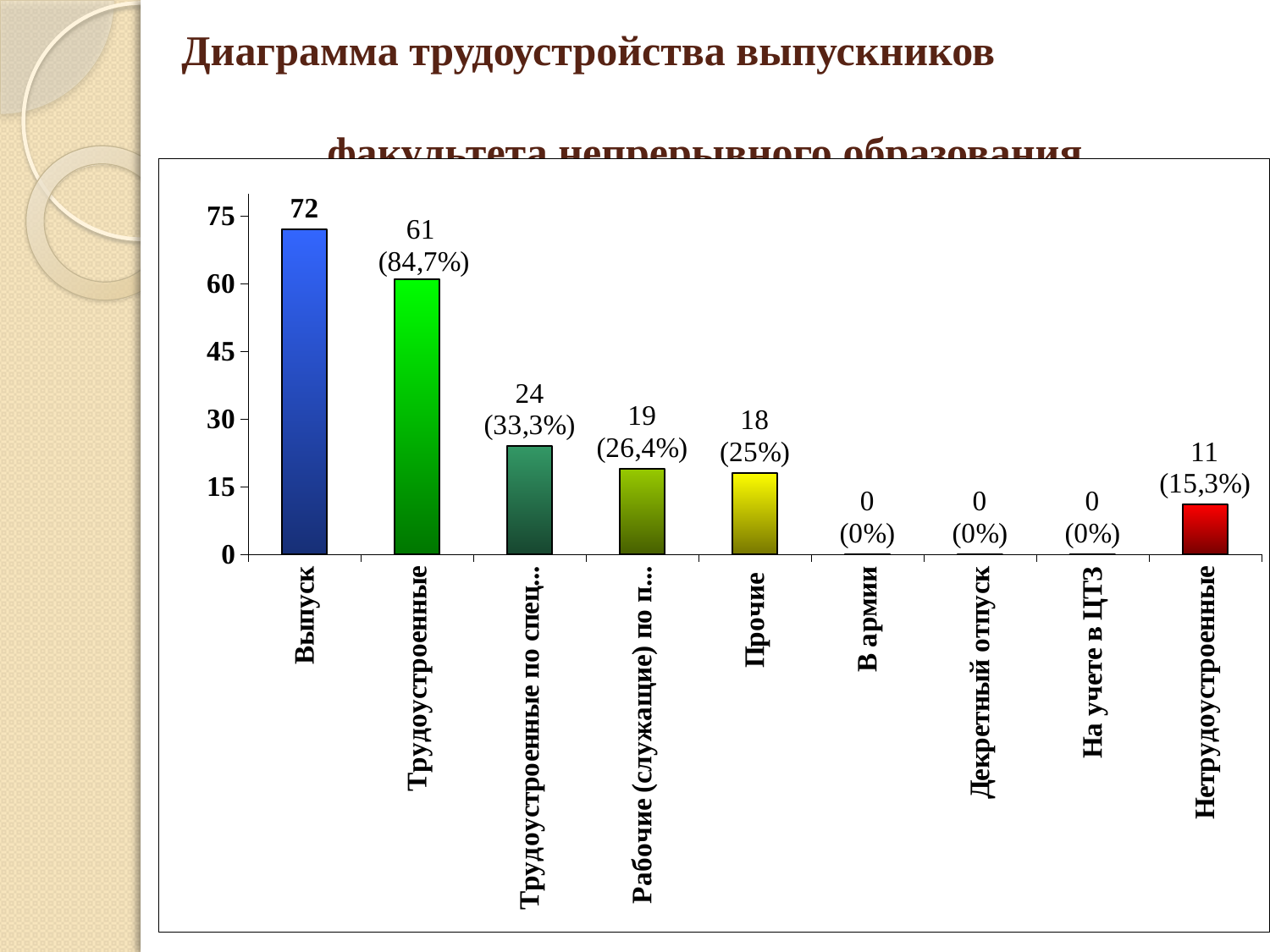
How many categories are shown on the x axis? 9 What is the value for Прочие? 18 Which category has the highest value? Выпуск What kind of chart is shown on the slide? bar chart Which is larger, the value for Прочие or the value for Нетрудоустроенные? Прочие How many categories have a value of 0? 3 What percentage is shown for Нетрудоустроенные? 15,3% What percentage is shown for Трудоустроенные? 84,7% Is the value for Трудоустроенные greater or less than 45? greater What is the value for Выпуск? 72 What is the difference between the values for Выпуск and Трудоустроенные? 11 What is the value for Трудоустроенные? 61